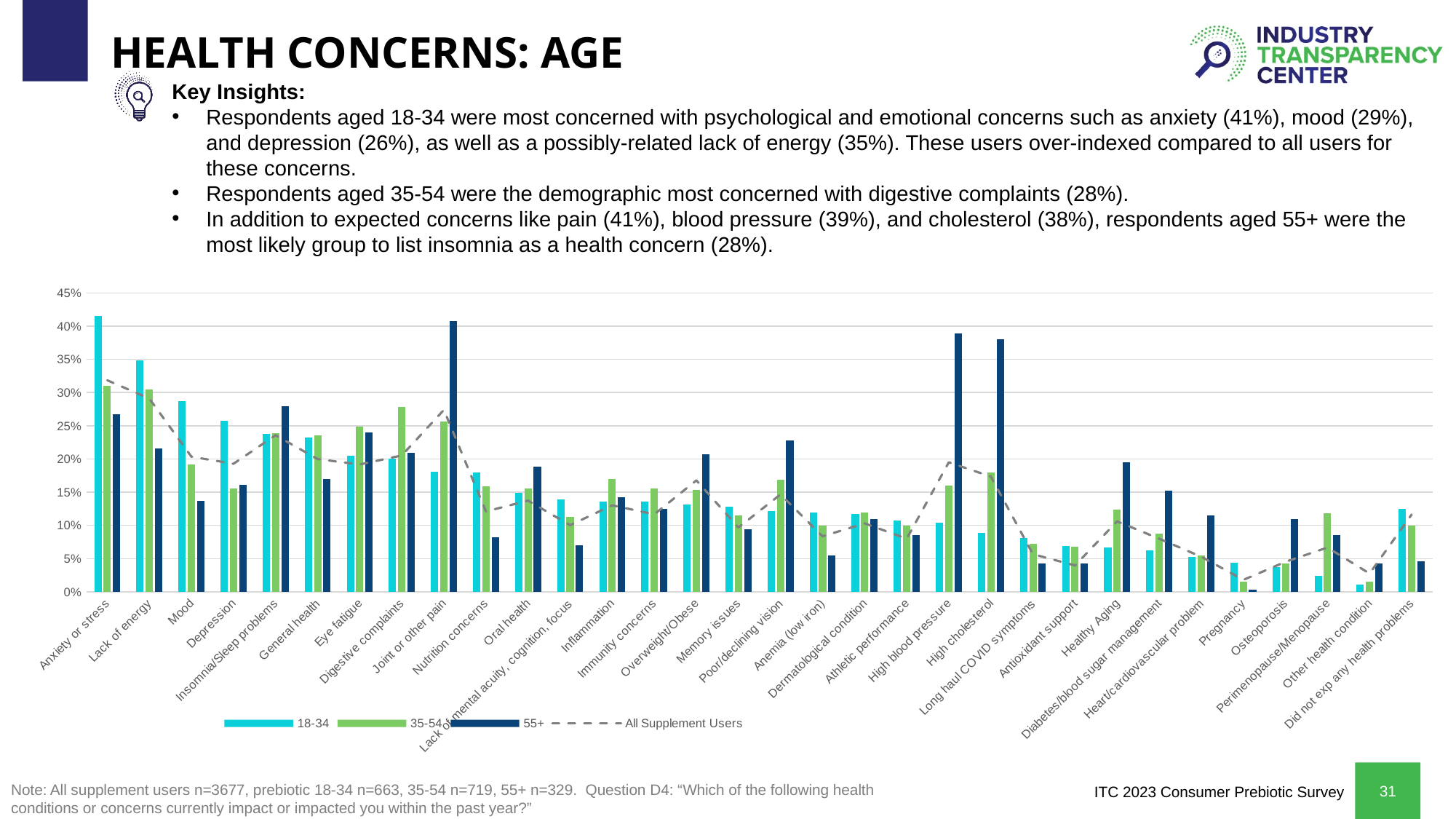
Is the 55+ value for High blood pressure greater or less than 35%? greater Is the 35-54 value for Digestive complaints greater or less than 25%? greater What kind of chart is shown on the slide? bar and line chart For Mood, which age group has the larger value: 18-34 or 55+? 18-34 How many series does the chart legend list? 4 For High cholesterol, which age group has the larger value: 55+ or 18-34? 55+ Which series is plotted as a dashed line rather than bars? All Supplement Users How many health concern categories are shown along the x axis? 32 Which health concern has the lowest value for the 55+ series? Pregnancy Is the 55+ value for Insomnia/Sleep problems greater or less than 25%? greater Which health concern has the highest value for the 18-34 series? Anxiety or stress